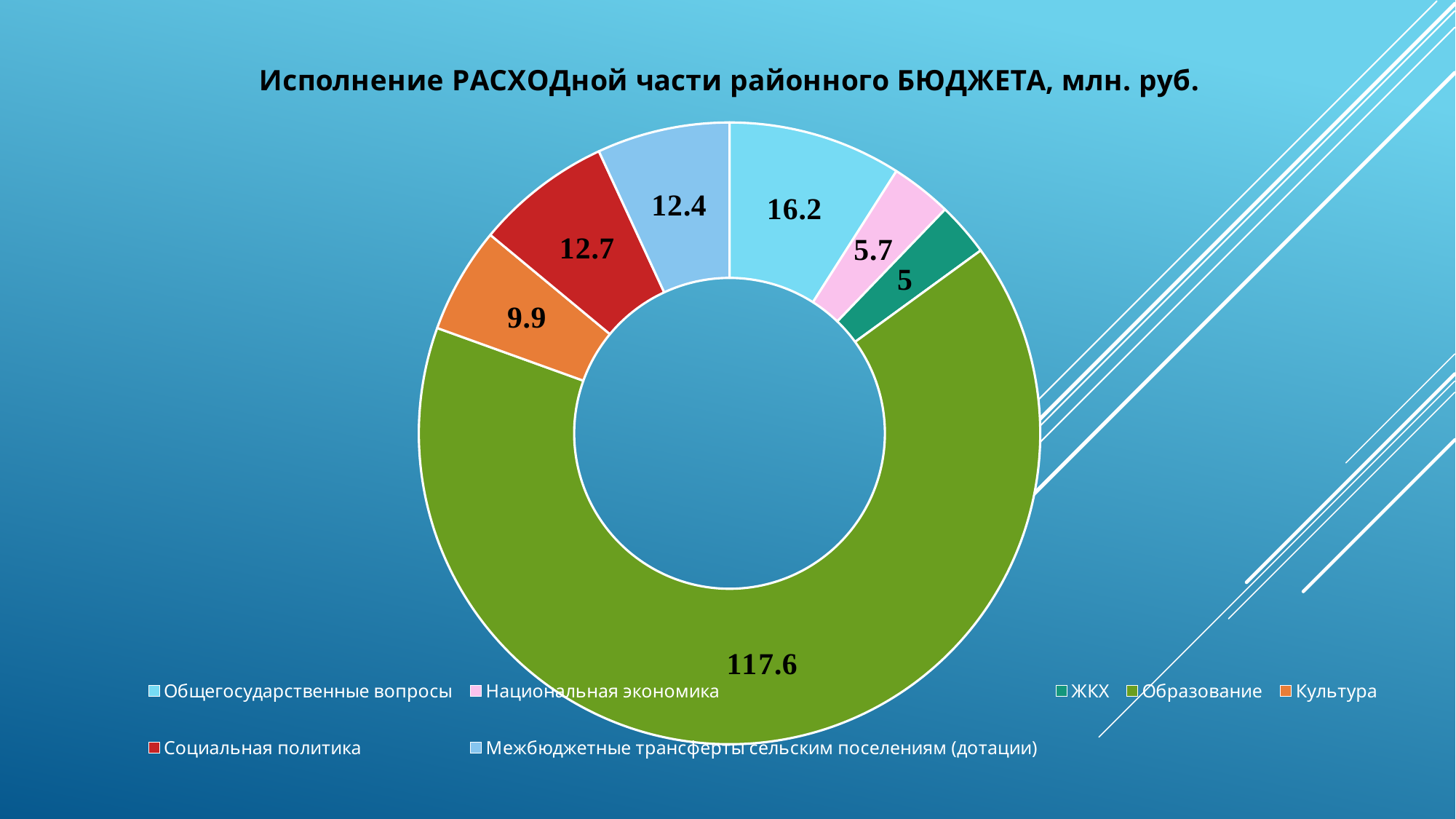
What is the difference between the values for Социальная политика and Культура? 2.8 What is the total of all the values shown in the chart? 179.5 How many categories does the chart show? 7 What is the value for Общегосударственные вопросы? 16.2 Which category has the smallest value? ЖКХ What is the value for Образование? 117.6 What is the title of the chart? Исполнение РАСХОДной части районного БЮДЖЕТА, млн. руб. What is the value for ЖКХ? 5 What is the value for Межбюджетные трансферты сельским поселениям (дотации)? 12.4 Which category has the largest value? Образование Which is larger, the value for Социальная политика or the value for Межбюджетные трансферты сельским поселениям (дотации)? Социальная политика What type of chart is shown on the slide? Doughnut (pie) chart